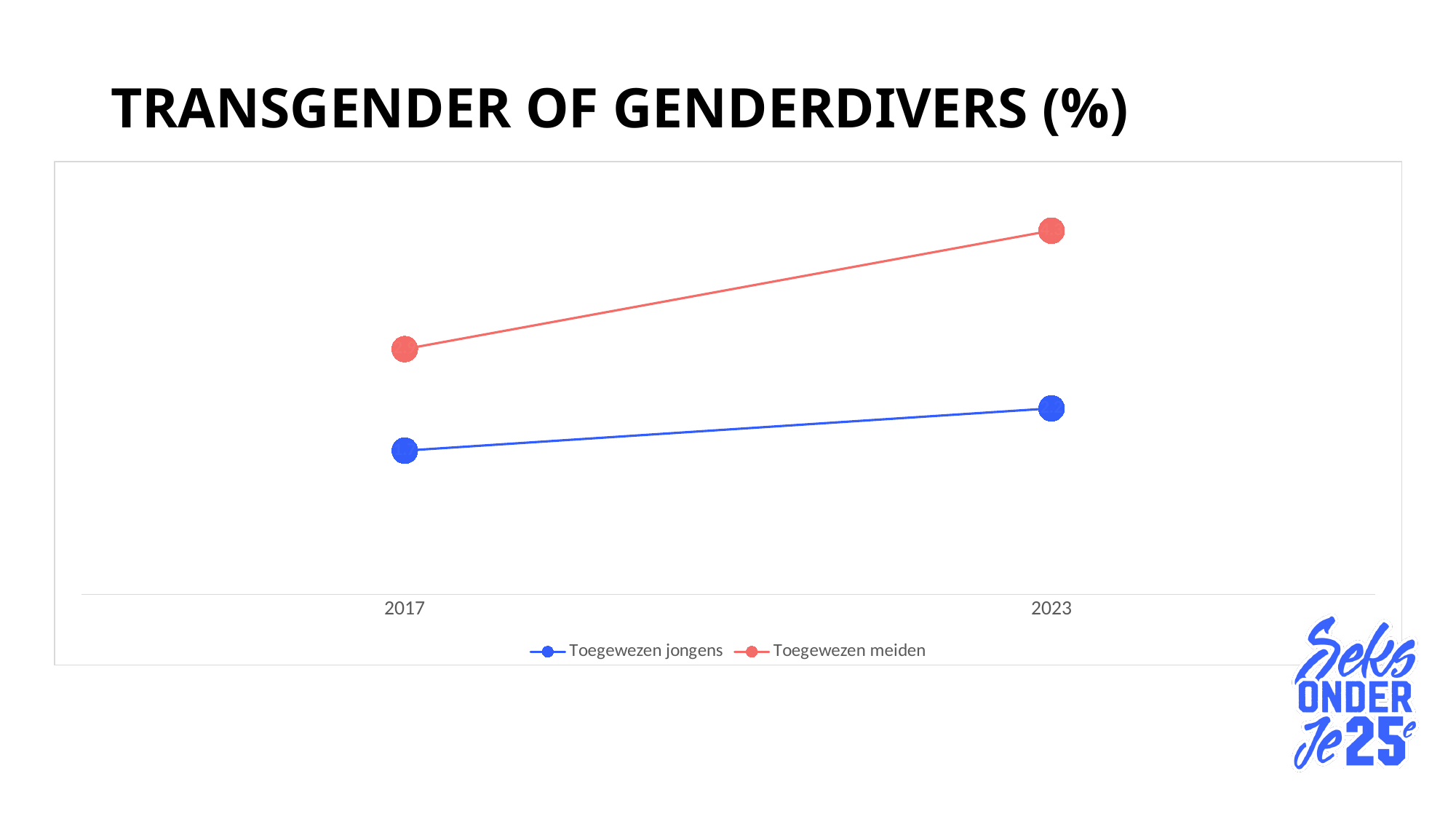
What colour is the line for Toegewezen jongens? blue Does the value for Toegewezen meiden rise or fall from 2017 to 2023? rise Which years are shown on the x axis? 2017 and 2023 How many years are shown on the x axis? 2 What kind of chart is shown on the slide? line chart In which year is the value for Toegewezen meiden highest? 2023 Which series has the lower value in 2017, Toegewezen jongens or Toegewezen meiden? Toegewezen jongens What is the title of the chart? TRANSGENDER OF GENDERDIVERS (%) How many series does the legend list? 2 In which year is the value for Toegewezen jongens lowest? 2017 Does the value for Toegewezen jongens rise or fall from 2017 to 2023? rise Which series has the higher value in 2023, Toegewezen jongens or Toegewezen meiden? Toegewezen meiden